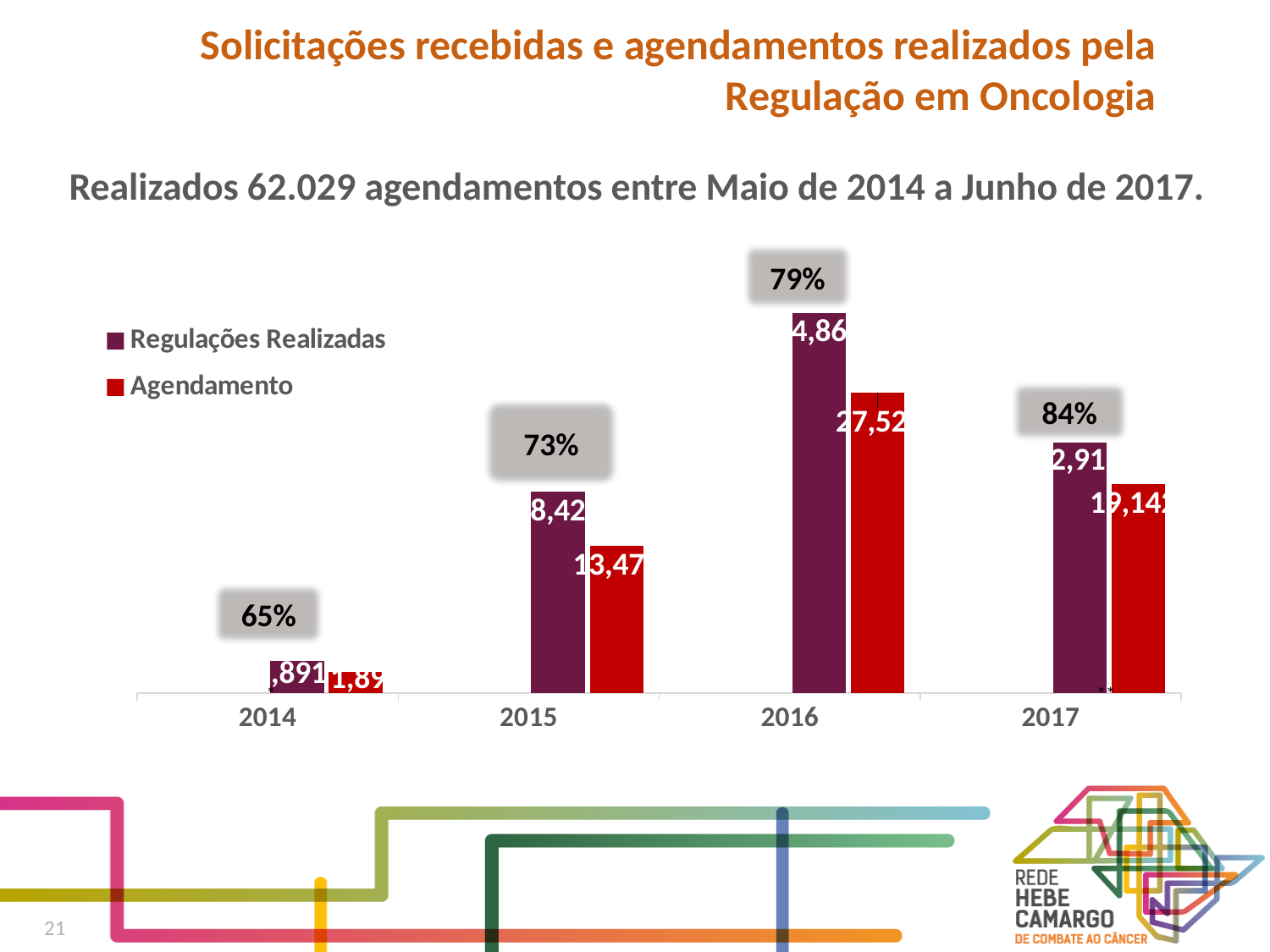
Which year has the lowest value for Agendamento? 2014 What percentage is shown above the 2017 bars? 84% Which year has the highest value for Agendamento? 2016 Do the percentages shown above the bar groups rise or fall from 2014 to 2017? rise Which series is shown in red? Agendamento Which is larger: Agendamento in 2015 or Agendamento in 2017? 2017 How many series does the legend list? 2 What kind of chart is shown on the slide? bar chart How many years are shown on the x axis? 4 What percentage is shown above the 2014 bars? 65% In 2016, which is larger: Regulações Realizadas or Agendamento? Regulações Realizadas Which year has the highest value for Regulações Realizadas? 2016